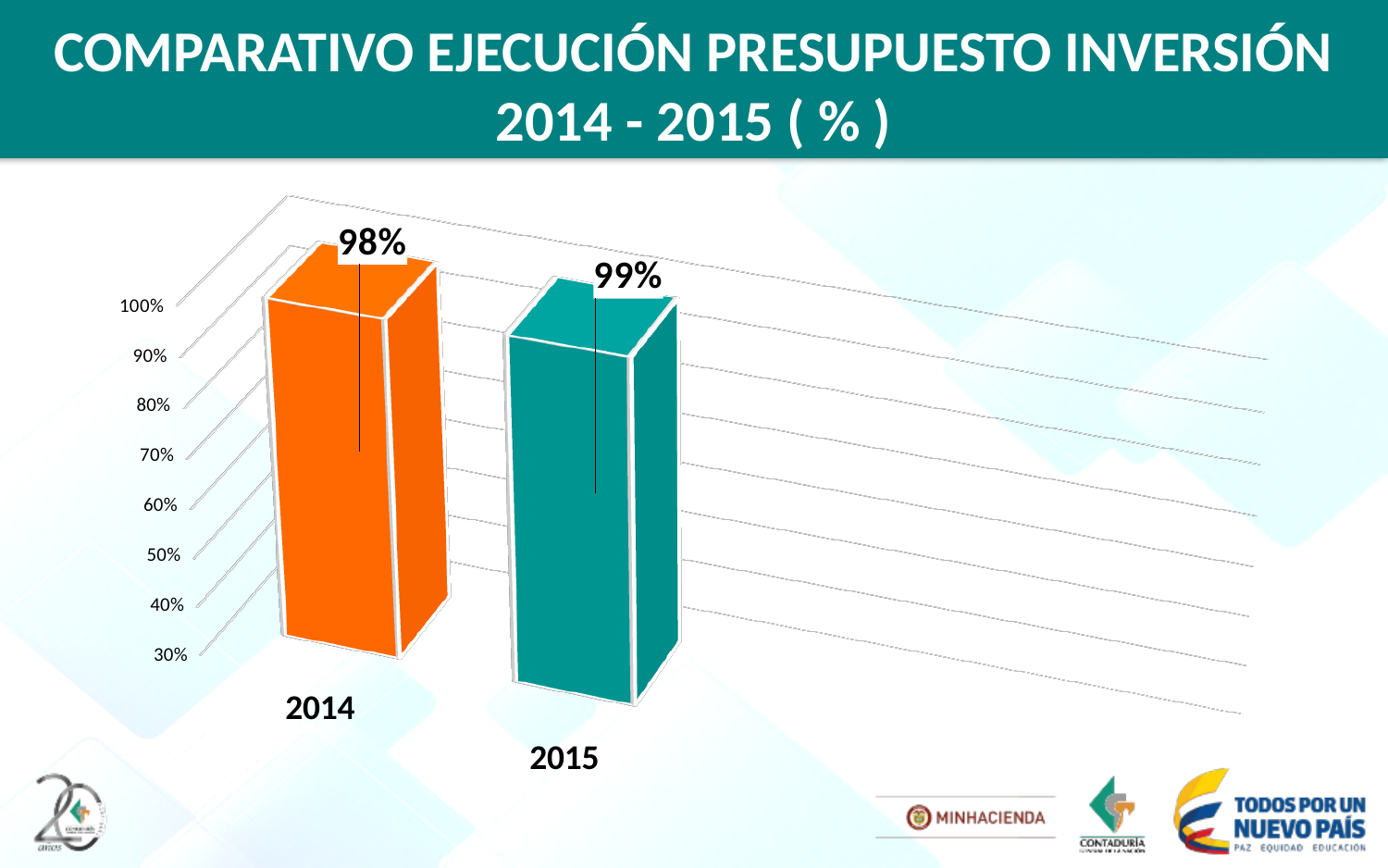
Is the value for 2014 greater or less than 90%? greater What is the value for 2014? 98% What colour is the bar for 2015? Teal Do the values rise or fall from 2014 to 2015? Rise Is the value for 2015 larger than the value for 2014? Yes Which year has the higher value? 2015 Which year has the lower value? 2014 How many categories are shown on the chart? 2 What is the value for 2015? 99% What is the title of the slide? COMPARATIVO EJECUCIÓN PRESUPUESTO INVERSIÓN 2014 - 2015 ( % ) What kind of chart is shown on the slide? Bar chart What is the difference between the 2015 and 2014 values? 1%